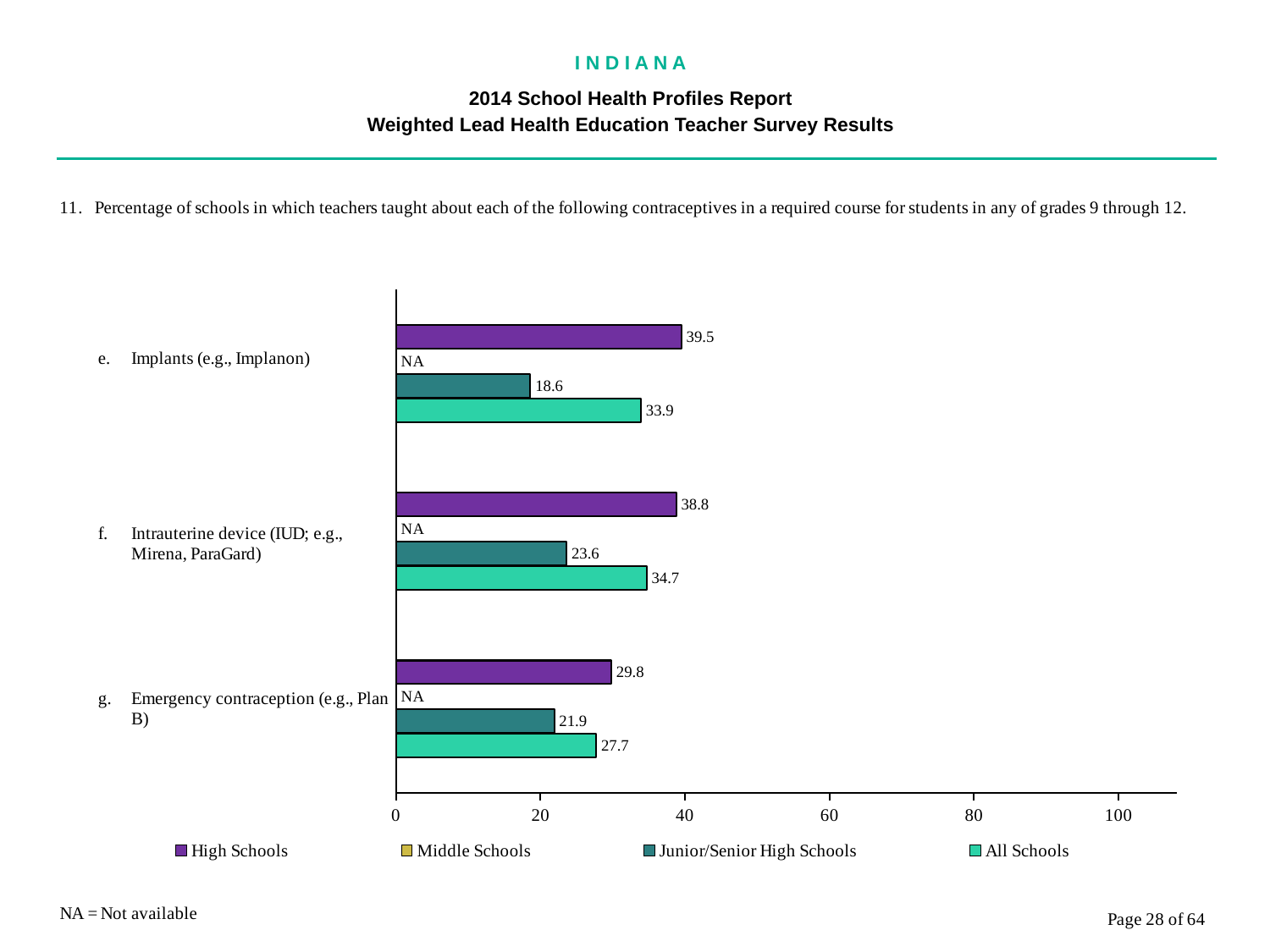
What kind of chart is shown on the slide? Bar chart Which is larger for Emergency contraception (e.g., Plan B): the High Schools value or the All Schools value? High Schools What is the difference between the High Schools and Junior/Senior High Schools values for Intrauterine device (IUD; e.g., Mirena, ParaGard)? 15.2 How many contraceptive categories are shown on the chart? 3 What is the value for High Schools for Implants (e.g., Implanon)? 39.5 How many series does the legend list? 4 What is shown for Middle Schools for Implants (e.g., Implanon)? NA Which category has the highest High Schools value? Implants (e.g., Implanon) What is the value for Junior/Senior High Schools for Emergency contraception (e.g., Plan B)? 21.9 Is the All Schools value for Implants (e.g., Implanon) greater or less than 40? less What is the value for All Schools for Intrauterine device (IUD; e.g., Mirena, ParaGard)? 34.7 Which category has the lowest Junior/Senior High Schools value? Implants (e.g., Implanon)